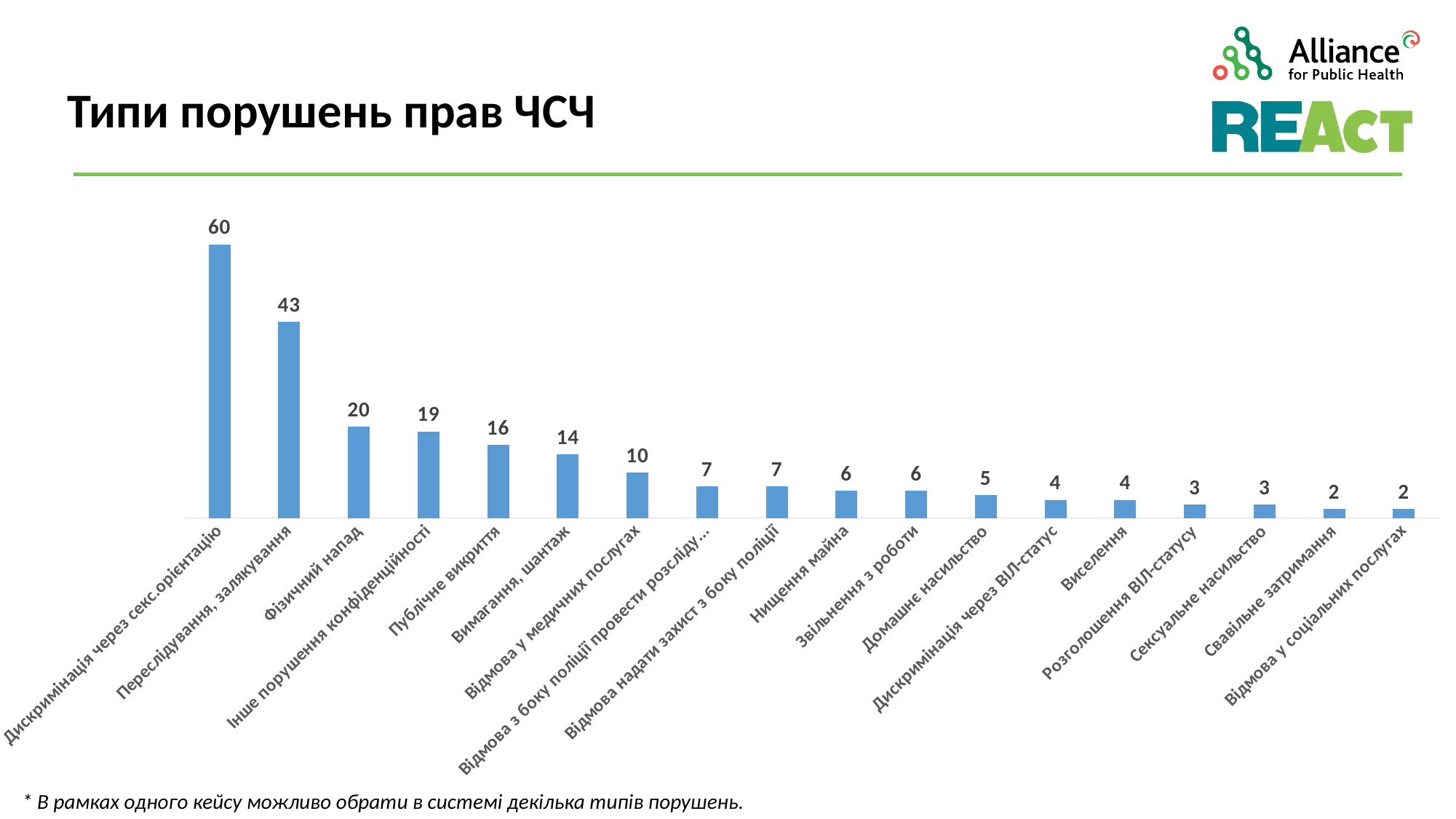
What is the difference between «Публічне викриття» and «Вимагання, шантаж»? 2 What is the title of the slide? Типи порушень прав ЧСЧ What is the difference between «Дискримінація через секс.орієнтацію» and «Переслідування, залякування»? 17 Which category has the highest value? Дискримінація через секс.орієнтацію What value is shown for «Виселення»? 4 Which is larger, «Інше порушення конфіденційності» or «Публічне викриття»? Інше порушення конфіденційності What value is shown for «Відмова у медичних послугах»? 10 How many categories are shown in the chart? 18 Which is larger, «Нищення майна» or «Розголошення ВІЛ-статусу»? Нищення майна What value is shown for «Домашнє насильство»? 5 What kind of chart is shown on the slide? Bar chart What value is shown for «Фізичний напад»? 20